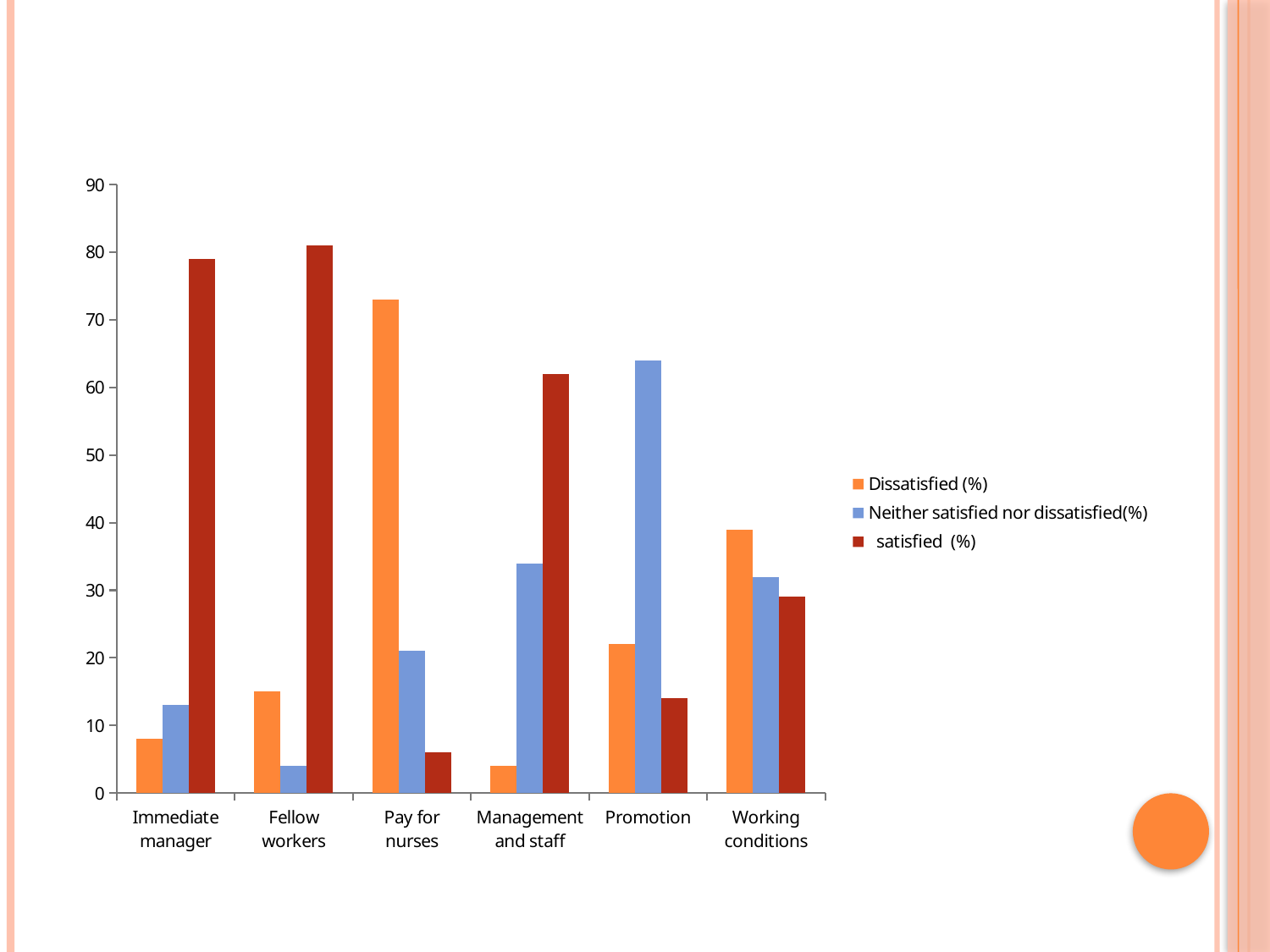
For Promotion, which is larger: the Dissatisfied (%) bar or the Neither satisfied nor dissatisfied(%) bar? Neither satisfied nor dissatisfied(%) How many categories are shown on the x axis? 6 For Working conditions, which is larger: the Dissatisfied (%) bar or the satisfied (%) bar? Dissatisfied (%) What colour represents the satisfied (%) series in the legend? Dark red Is the Dissatisfied (%) value for Pay for nurses greater or less than 70? greater Which category has the lowest satisfied (%) bar? Pay for nurses Which category has the highest Neither satisfied nor dissatisfied(%) bar? Promotion Is the Dissatisfied (%) value for Fellow workers greater or less than 20? less Which category has the lowest Dissatisfied (%) bar? Management and staff How many series does the legend list? 3 What kind of chart is shown on the slide? Bar chart Which category has the highest Dissatisfied (%) bar? Pay for nurses